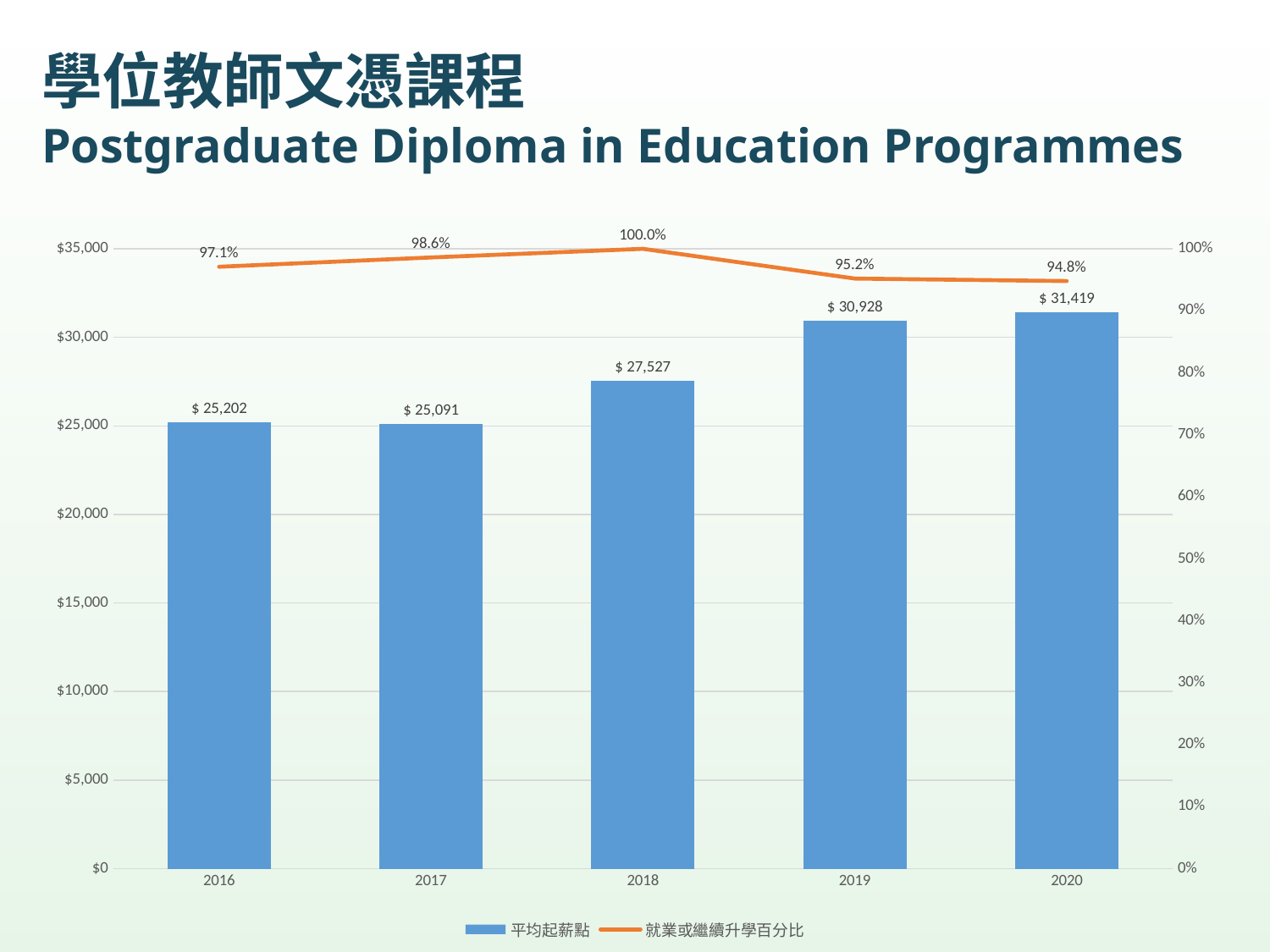
Which year has the lowest employment or further study percentage (就業或繼續升學百分比)? 2020 Which year has the highest employment or further study percentage (就業或繼續升學百分比)? 2018 What is the difference in average starting salary (平均起薪點) between 2019 and 2018? $ 3,401 What is the average starting salary (平均起薪點) for 2018? $ 27,527 What is the average starting salary (平均起薪點) for 2020? $ 31,419 What colour is the line for 就業或繼續升學百分比? orange Does the average starting salary (平均起薪點) rise or fall from 2017 to 2020? rise Which year has the highest average starting salary (平均起薪點)? 2020 How many series does the legend list? 2 Which year has a higher average starting salary (平均起薪點), 2016 or 2017? 2016 What is the employment or further study percentage (就業或繼續升學百分比) for 2017? 98.6% How many years are shown on the x axis of the chart? 5